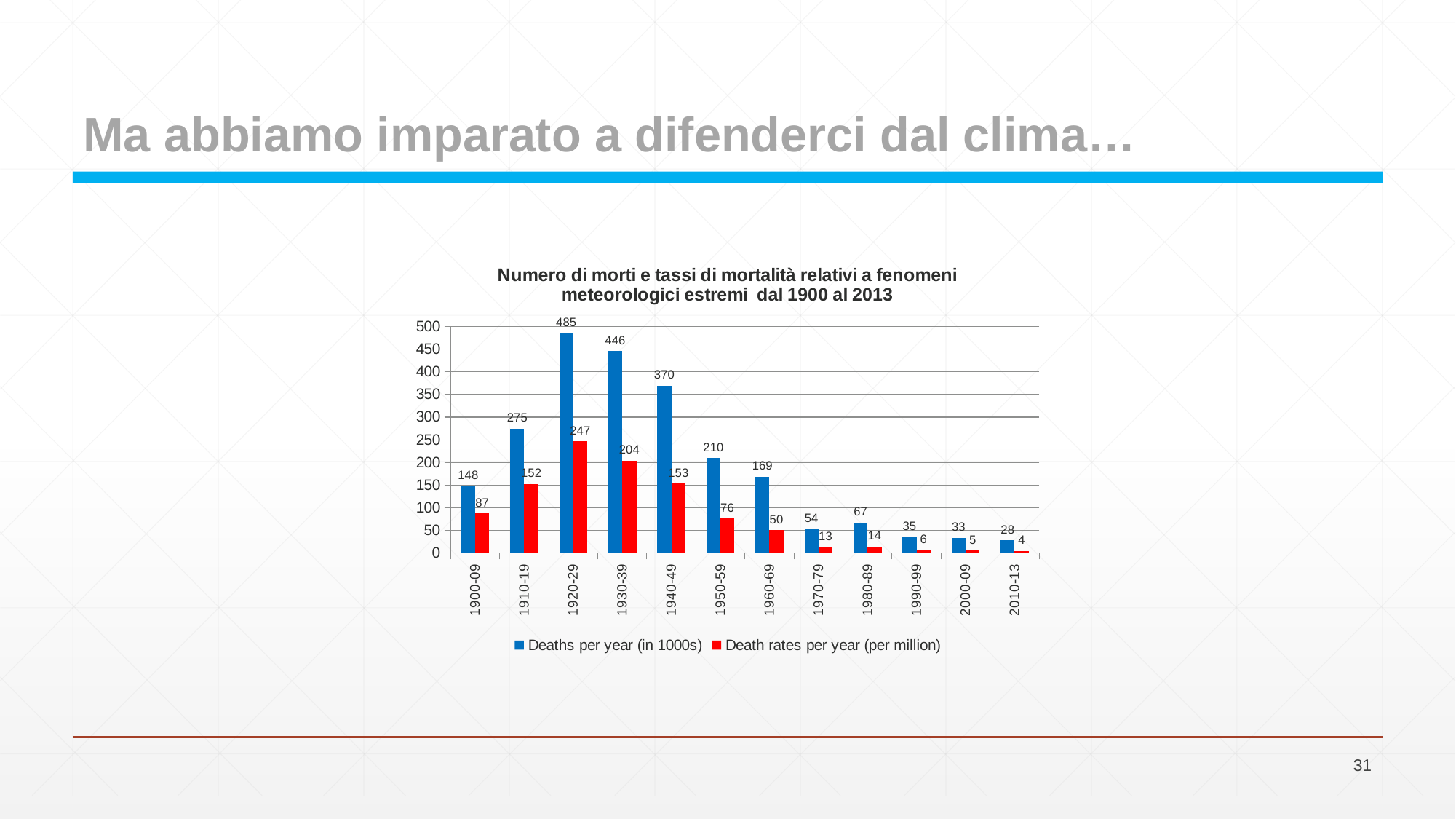
Which is larger: Death rates per year (per million) for 1910-19 or for 1940-49? 1940-49 Do the values for Deaths per year (in 1000s) rise or fall from 1920-29 to 2010-13? Fall What is the difference between Deaths per year (in 1000s) for 1920-29 and 1930-39? 39 How many time periods are shown on the x axis? 12 What is the value of Deaths per year (in 1000s) for 1920-29? 485 Which decade has the highest value for Deaths per year (in 1000s)? 1920-29 What is the value of Death rates per year (per million) for 1930-39? 204 How many series does the legend list? 2 Which period has the lowest value for Death rates per year (per million)? 2010-13 Which colour represents Death rates per year (per million) in the chart? Red What kind of chart is shown on the slide? Bar chart Is the value of Deaths per year (in 1000s) for 1940-49 greater or less than 350? greater